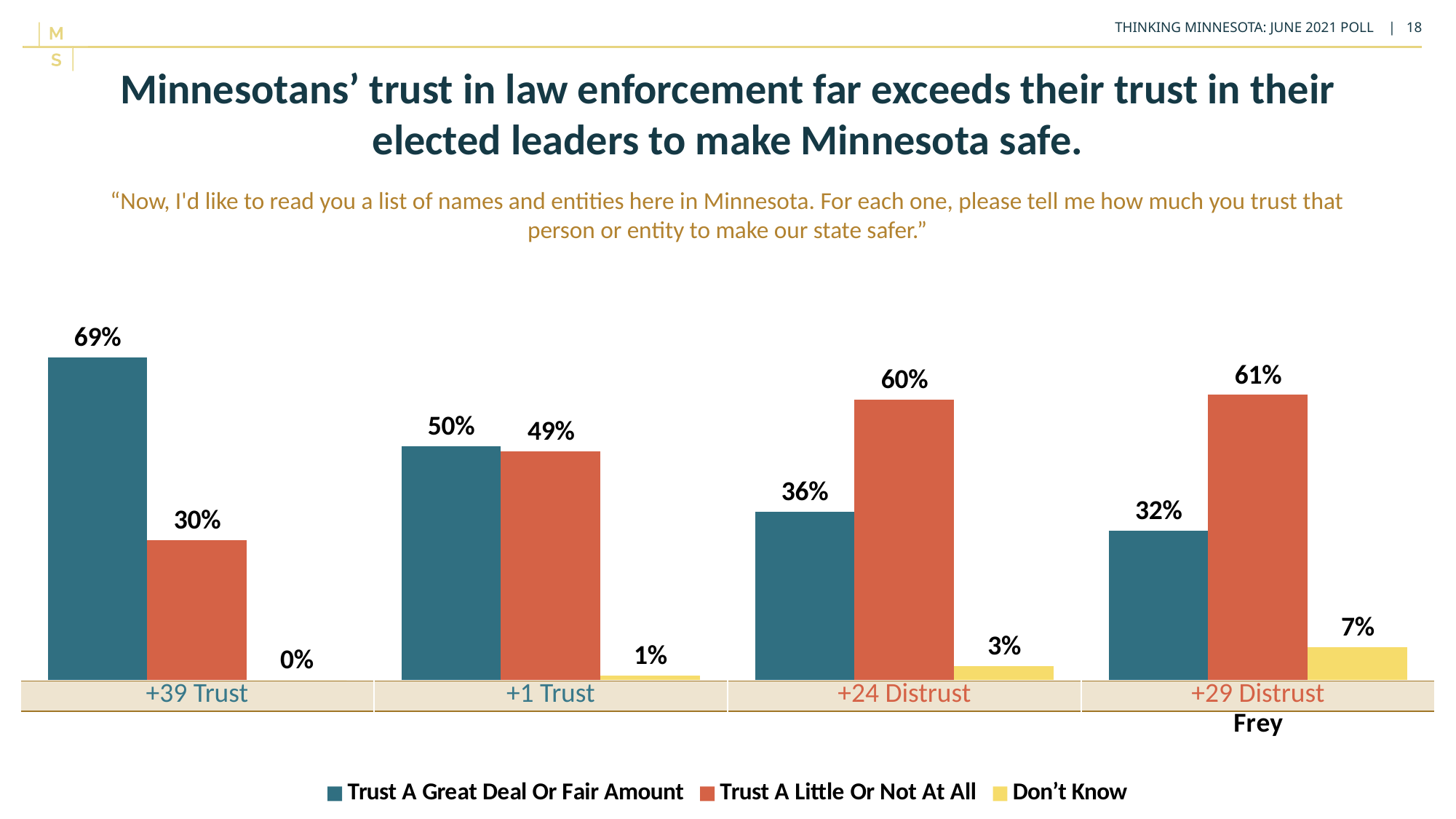
Which group has the highest 'Trust A Great Deal Or Fair Amount' value? +39 Trust What is the 'Trust A Great Deal Or Fair Amount' value for the group labelled '+39 Trust'? 69% What is the 'Don't Know' value for Frey? 7% In the group labelled '+1 Trust', which is larger: 'Trust A Great Deal Or Fair Amount' or 'Trust A Little Or Not At All'? Trust A Great Deal Or Fair Amount How many groups of bars are shown in the chart? 4 How many series does the legend list? 3 Which group has the lowest 'Don't Know' value? +39 Trust What is the difference between the 'Trust A Little Or Not At All' and 'Trust A Great Deal Or Fair Amount' values for Frey? 29% What type of chart is shown on the slide? Bar chart What is the 'Trust A Little Or Not At All' value for Frey? 61% What percentage of respondents trust Frey a great deal or a fair amount? 32% What is the 'Trust A Little Or Not At All' value for the group labelled '+24 Distrust'? 60%